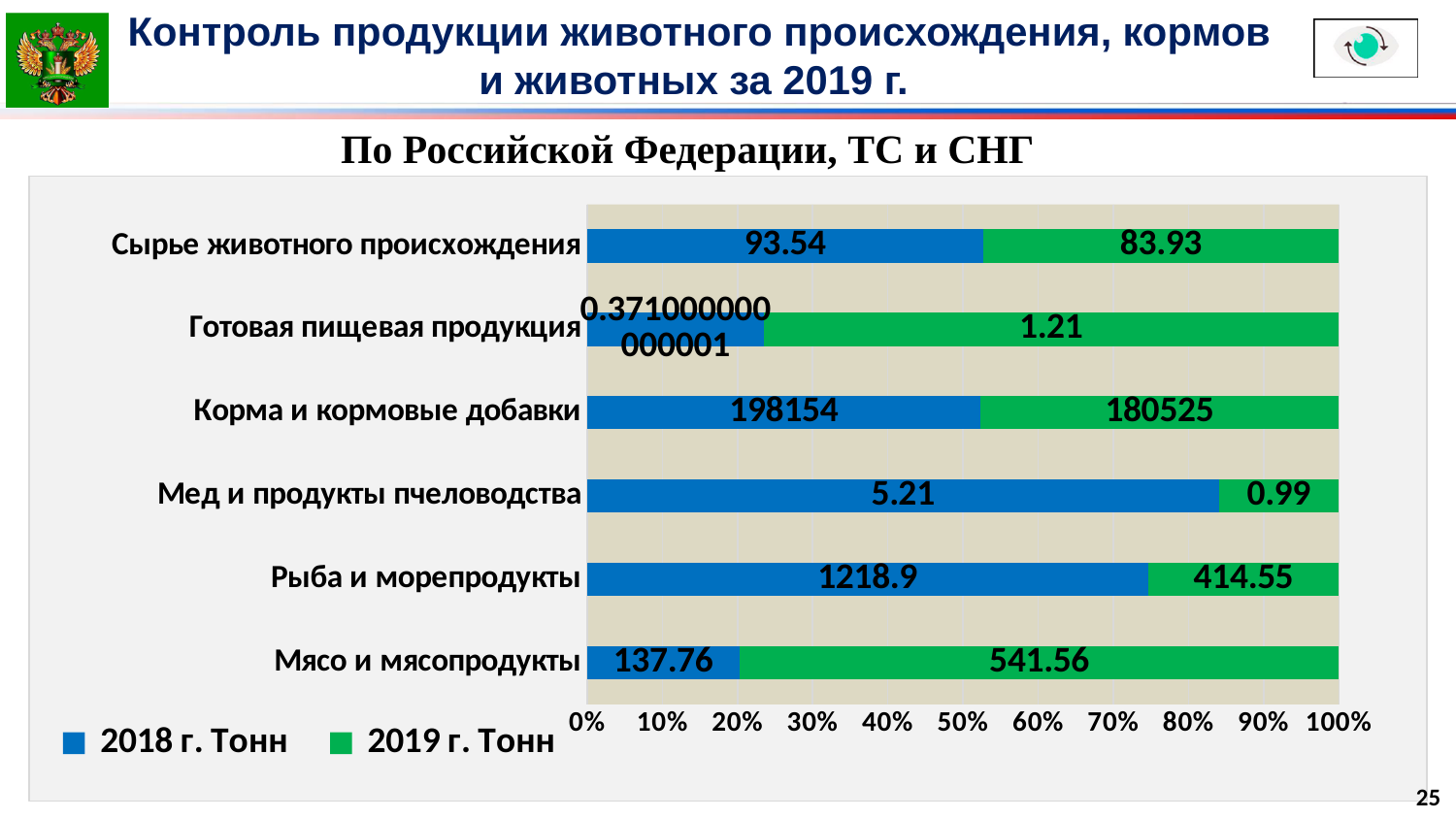
What is the 2019 г. Тонн value for Рыба и морепродукты? 414.55 Which category has the highest 2019 г. Тонн value? Корма и кормовые добавки What is the 2019 г. Тонн value for Мед и продукты пчеловодства? 0.99 How many series does the legend list? 2 What is the 2018 г. Тонн value for Корма и кормовые добавки? 198154 For Рыба и морепродукты, which is larger: the 2018 г. Тонн value or the 2019 г. Тонн value? 2018 г. Тонн What kind of chart is shown on the slide? Stacked bar chart What is the difference between the 2018 г. Тонн and 2019 г. Тонн values for Корма и кормовые добавки? 17629 What is the difference between the 2019 г. Тонн and 2018 г. Тонн values for Мясо и мясопродукты? 403.8 Which category has the lowest 2019 г. Тонн value? Мед и продукты пчеловодства What is the 2018 г. Тонн value for Мясо и мясопродукты? 137.76 How many categories are shown on the chart? 6